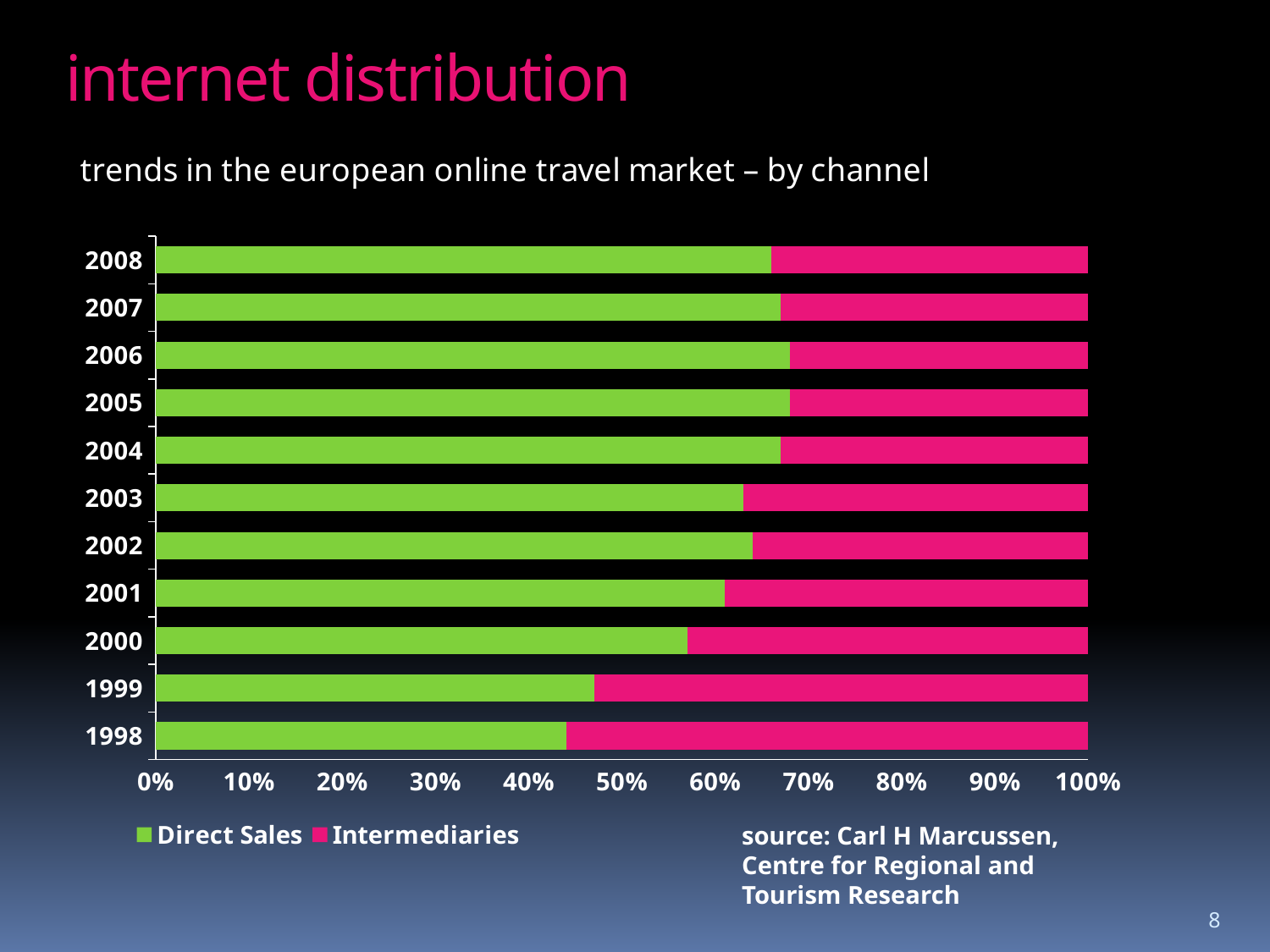
Does the Direct Sales share generally rise or fall from 1998 to 2008? rise Which year has the lowest Direct Sales share? 1998 Which year has the highest Intermediaries share? 1998 Which is larger in 2003, the Direct Sales share or the Intermediaries share? Direct Sales How many years are shown on the chart? 11 Is the Direct Sales value for 2008 greater or less than 60%? greater Is the Intermediaries share for 2005 greater or less than 40%? less Is the Direct Sales value for 1998 greater or less than 50%? less Which series is shown in green? Direct Sales How many series does the legend list? 2 What kind of chart is shown on the slide? bar chart